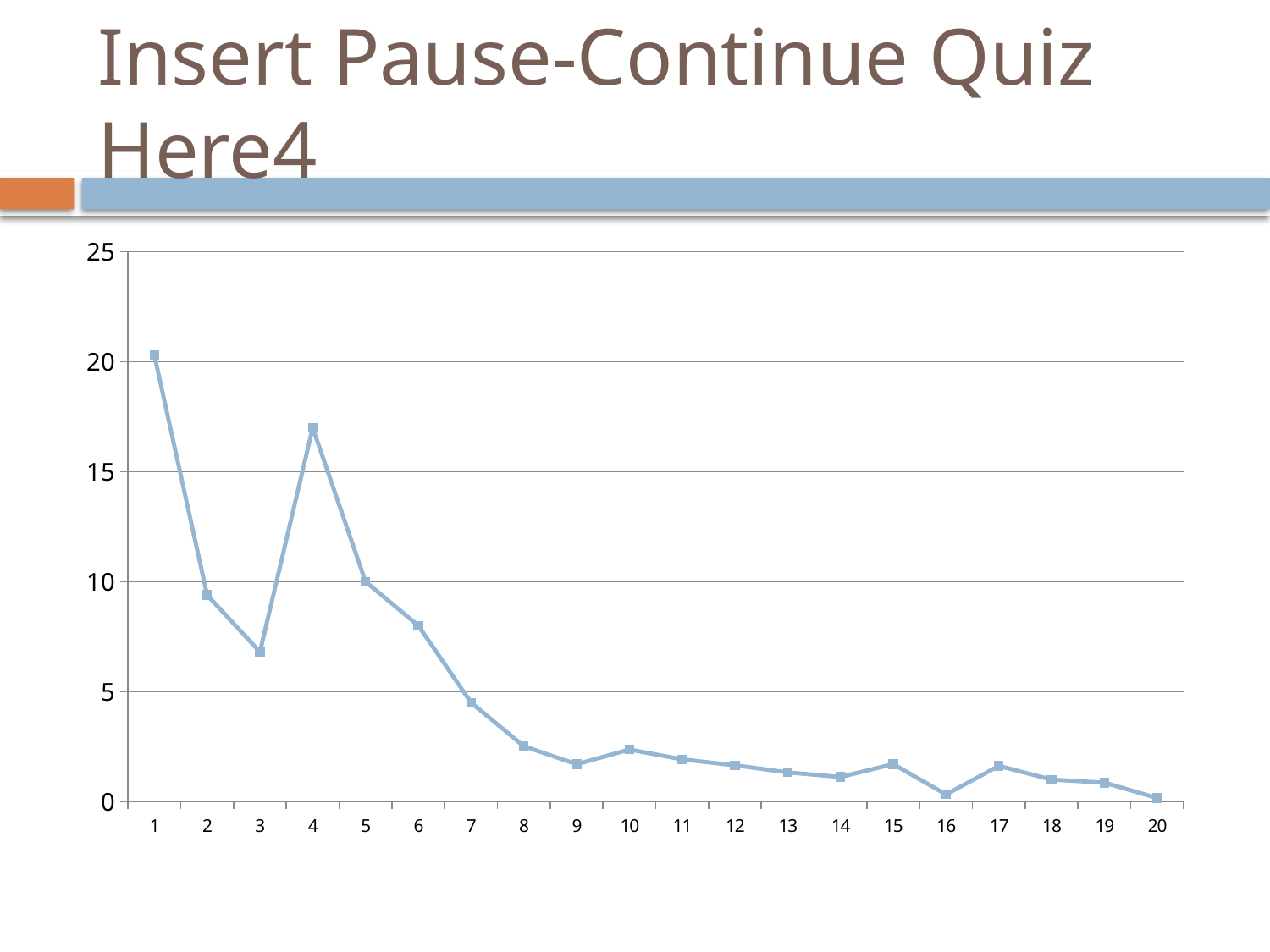
Is the value at x = 12 greater or less than 5? less Overall, do the values rise or fall from x = 1 to x = 20? fall Is the value at x = 7 greater or less than 5? less Is the value at x = 3 greater or less than 5? greater Which has the larger value, x = 4 or x = 6? 4 Which x-axis category has the highest value? 1 How many points are plotted along the x axis? 20 Which has the larger value, x = 2 or x = 3? 2 What kind of chart is shown on the slide? line chart